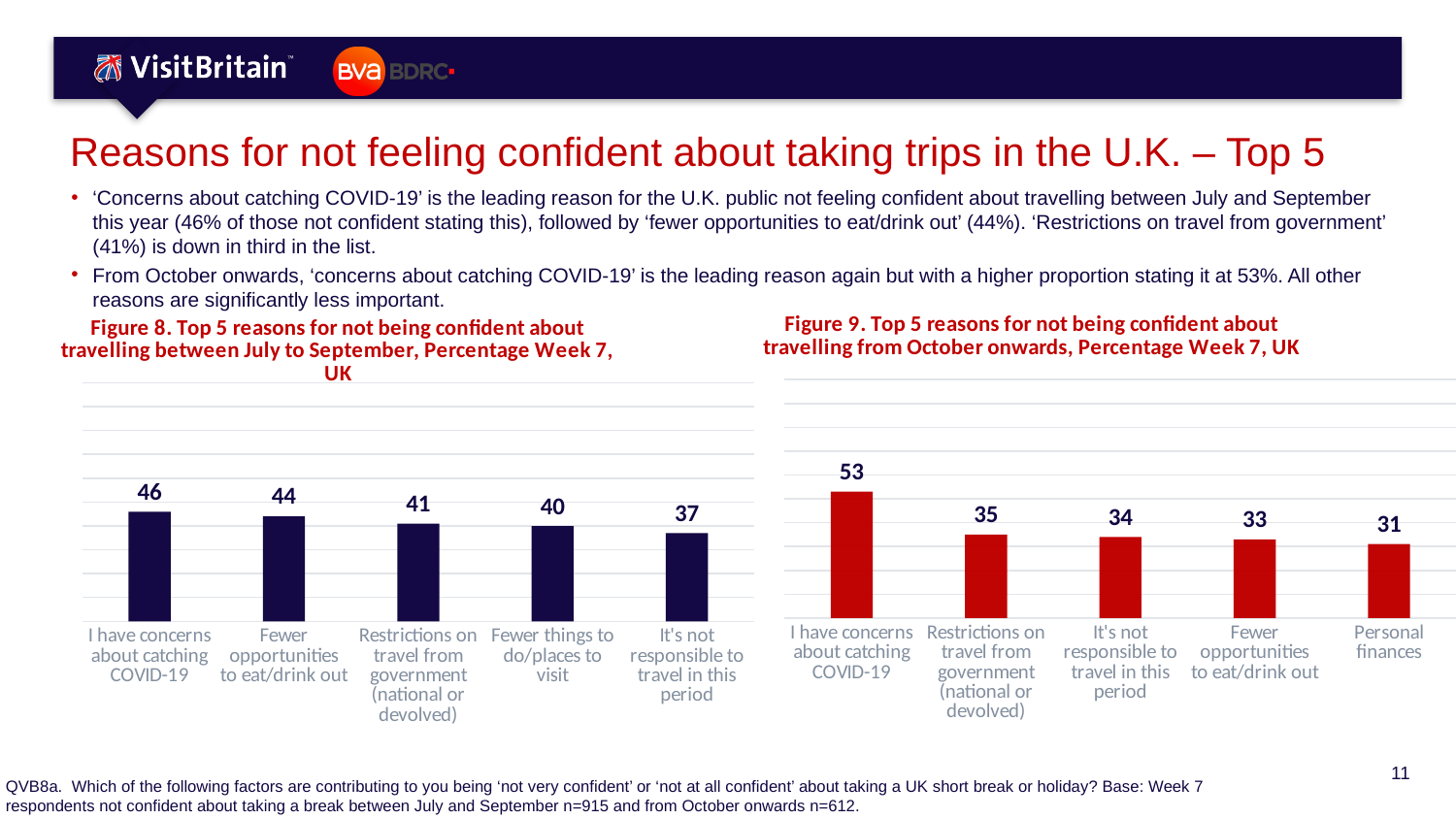
How many bars are shown in Figure 8 (July to September)? 5 In Figure 8 (July to September), which reason has the lowest value? It's not responsible to travel in this period In Figure 9 (October onwards), which is larger: 'Fewer opportunities to eat/drink out' or 'Personal finances'? Fewer opportunities to eat/drink out In Figure 9 (October onwards), what is the difference between 'I have concerns about catching COVID-19' and 'Restrictions on travel from government (national or devolved)'? 18 What colour are the bars in Figure 9 (October onwards)? Red In Figure 8 (July to September), what is the value for 'Fewer things to do/places to visit'? 40 In Figure 8 (July to September), what is the value for 'I have concerns about catching COVID-19'? 46 In Figure 8 (July to September), do the values rise or fall from left to right? Fall In Figure 9 (October onwards), which reason has the highest value? I have concerns about catching COVID-19 In Figure 8 (July to September), what is the difference between 'I have concerns about catching COVID-19' and 'Fewer opportunities to eat/drink out'? 2 What type of chart is Figure 9 (October onwards)? Bar chart In Figure 9 (October onwards), what is the value for 'Personal finances'? 31